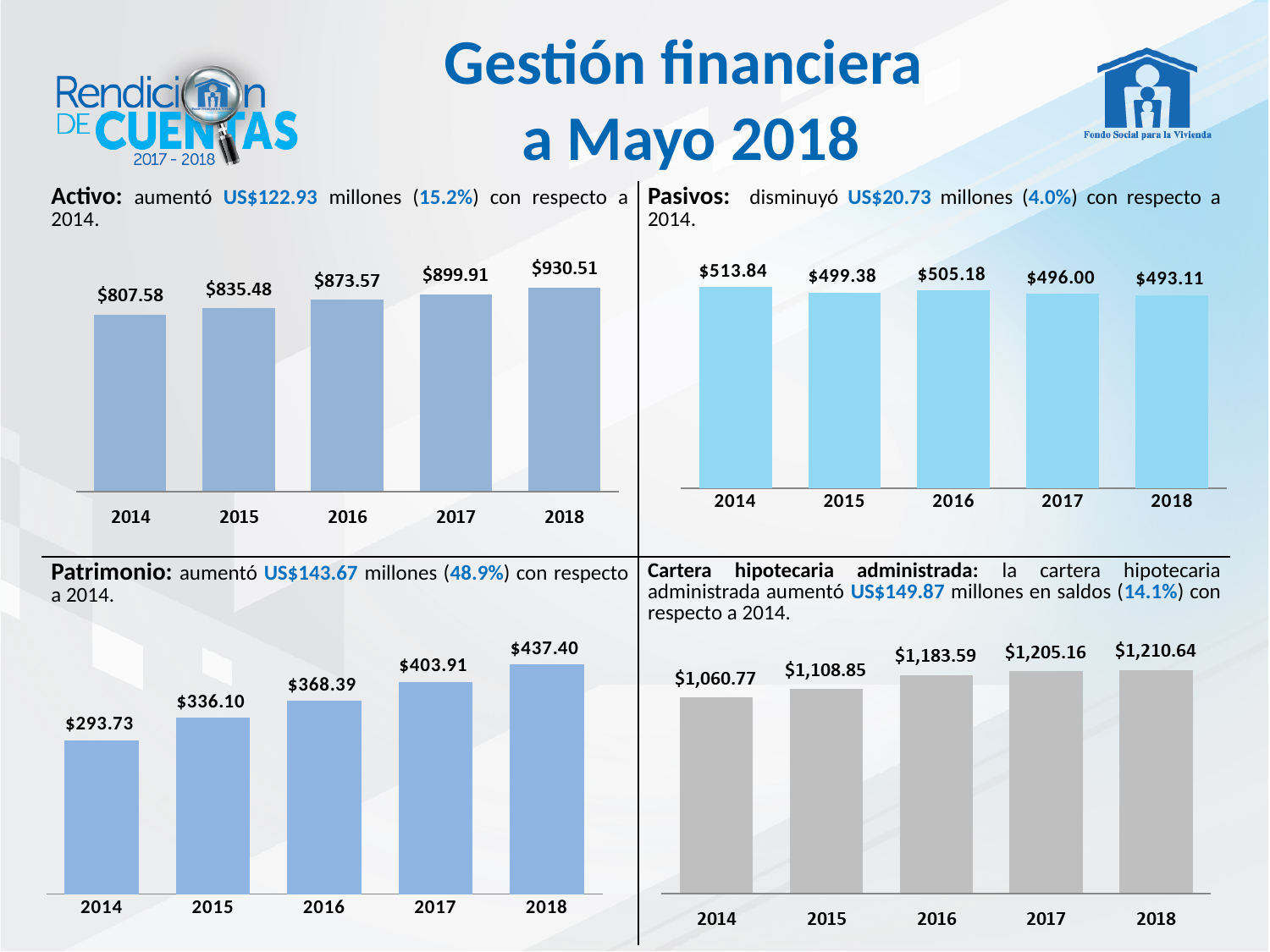
In the Activo chart (top left), what is the value for 2016? $873.57 In the Cartera hipotecaria administrada chart (bottom right), what is the value for 2015? $1,108.85 What is the title of the slide? Gestión financiera a Mayo 2018 In the Pasivos chart (top right), which year has the highest value? 2014 In the Cartera hipotecaria administrada chart (bottom right), is the value for 2016 larger or smaller than the value for 2017? smaller In the Pasivos chart (top right), what is the value for 2017? $496.00 In the Patrimonio chart (bottom left), what is the difference between the 2018 and 2014 values? $143.67 In the Patrimonio chart (bottom left), which year has the lowest value? 2014 In the Activo chart (top left), do the values rise or fall from 2014 to 2018? rise How many years are shown on the x axis of the Pasivos chart (top right)? 5 What kind of chart is the Patrimonio chart (bottom left)? bar chart In the Activo chart (top left), what is the difference between the 2018 and 2017 values? $30.60